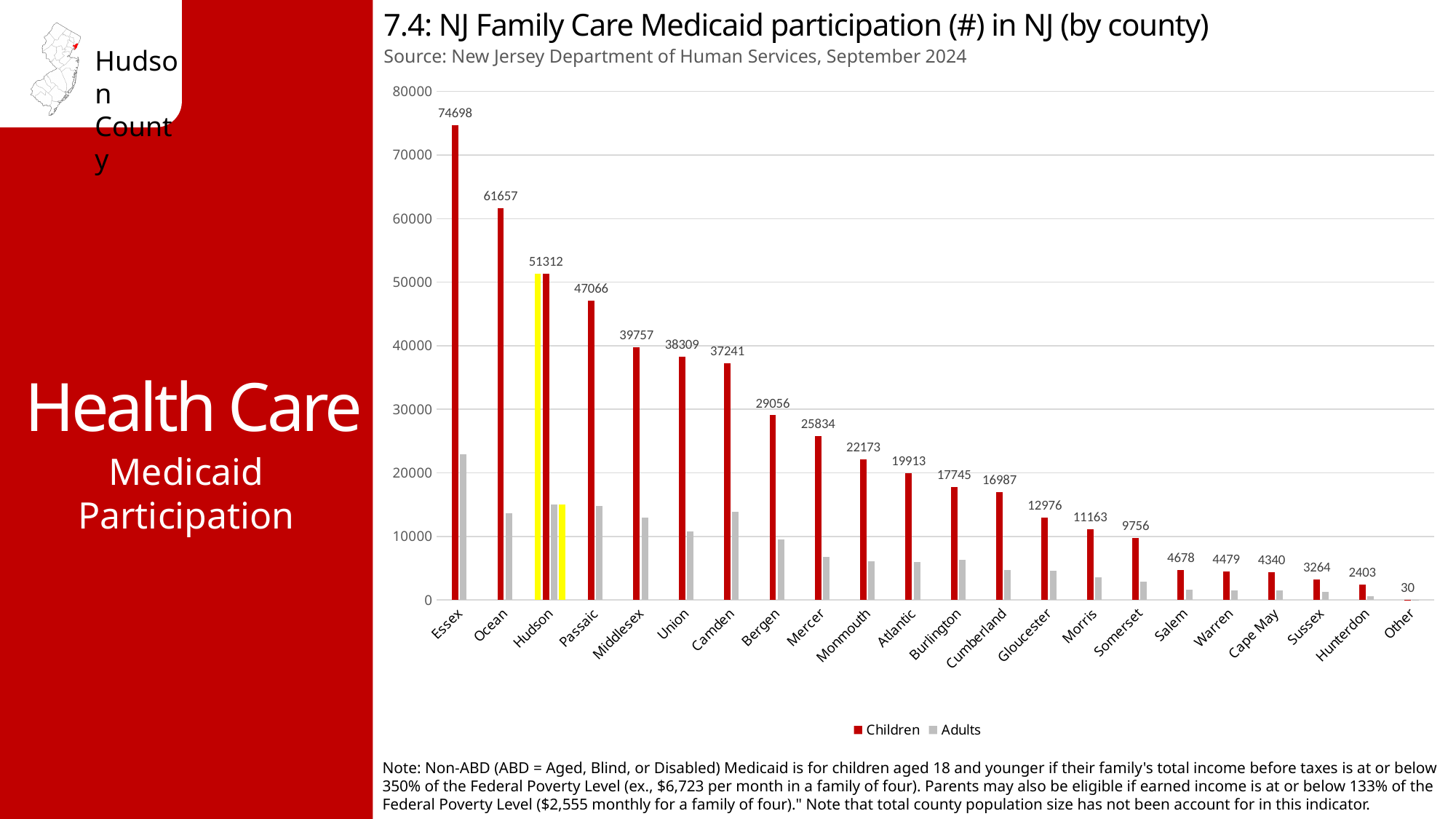
Do the Children values rise or fall from Essex to Hunterdon along the x axis? Fall How many categories are shown on the x axis? 22 Which category has the lowest Children value? Other What is the Children value for Hudson? 51312 Which county has the highest Children value? Essex What kind of chart is shown? Bar chart What is the difference between the Children values for Essex and Ocean? 13041 Which has a larger Children value, Passaic or Middlesex? Passaic What is the Children value for Bergen? 29056 Is the Adults value for Essex greater or less than 20000? greater Is the Adults value for Union greater or less than 20000? less How many series does the legend list? 2